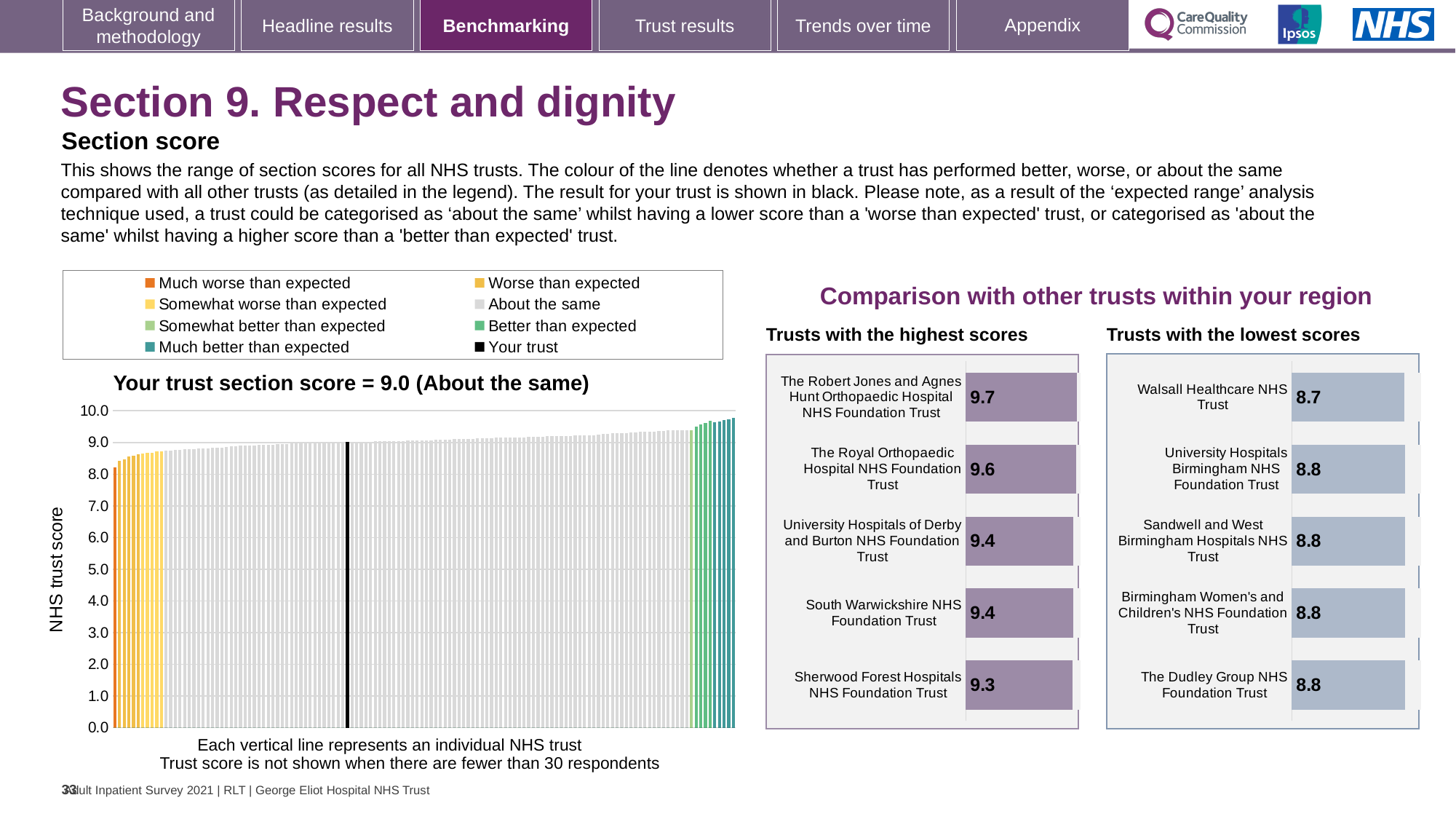
What kind of chart is the 'Your trust section score' chart on the left? Bar chart How many trusts are listed in the 'Trusts with the lowest scores' chart? 5 In the 'Trusts with the lowest scores' chart, what is the score for Walsall Healthcare NHS Trust? 8.7 How many entries does the legend above the 'Your trust section score' chart list? 8 In the 'Your trust section score' chart, what is the section score for your trust? 9.0 How many trusts are listed in the 'Trusts with the highest scores' chart? 5 In the 'Your trust section score' chart, do the trust scores rise or fall from left to right? Rise In the 'Trusts with the lowest scores' chart, which trust has the lowest score? Walsall Healthcare NHS Trust In the 'Trusts with the highest scores' chart, what is the difference between the scores of The Robert Jones and Agnes Hunt Orthopaedic Hospital NHS Foundation Trust and Sherwood Forest Hospitals NHS Foundation Trust? 0.4 In the 'Trusts with the highest scores' chart, which has the higher score: The Royal Orthopaedic Hospital NHS Foundation Trust or University Hospitals of Derby and Burton NHS Foundation Trust? The Royal Orthopaedic Hospital NHS Foundation Trust In the 'Trusts with the highest scores' chart, what is the score for The Robert Jones and Agnes Hunt Orthopaedic Hospital NHS Foundation Trust? 9.7 In the 'Trusts with the highest scores' chart, which trust has the highest score? The Robert Jones and Agnes Hunt Orthopaedic Hospital NHS Foundation Trust